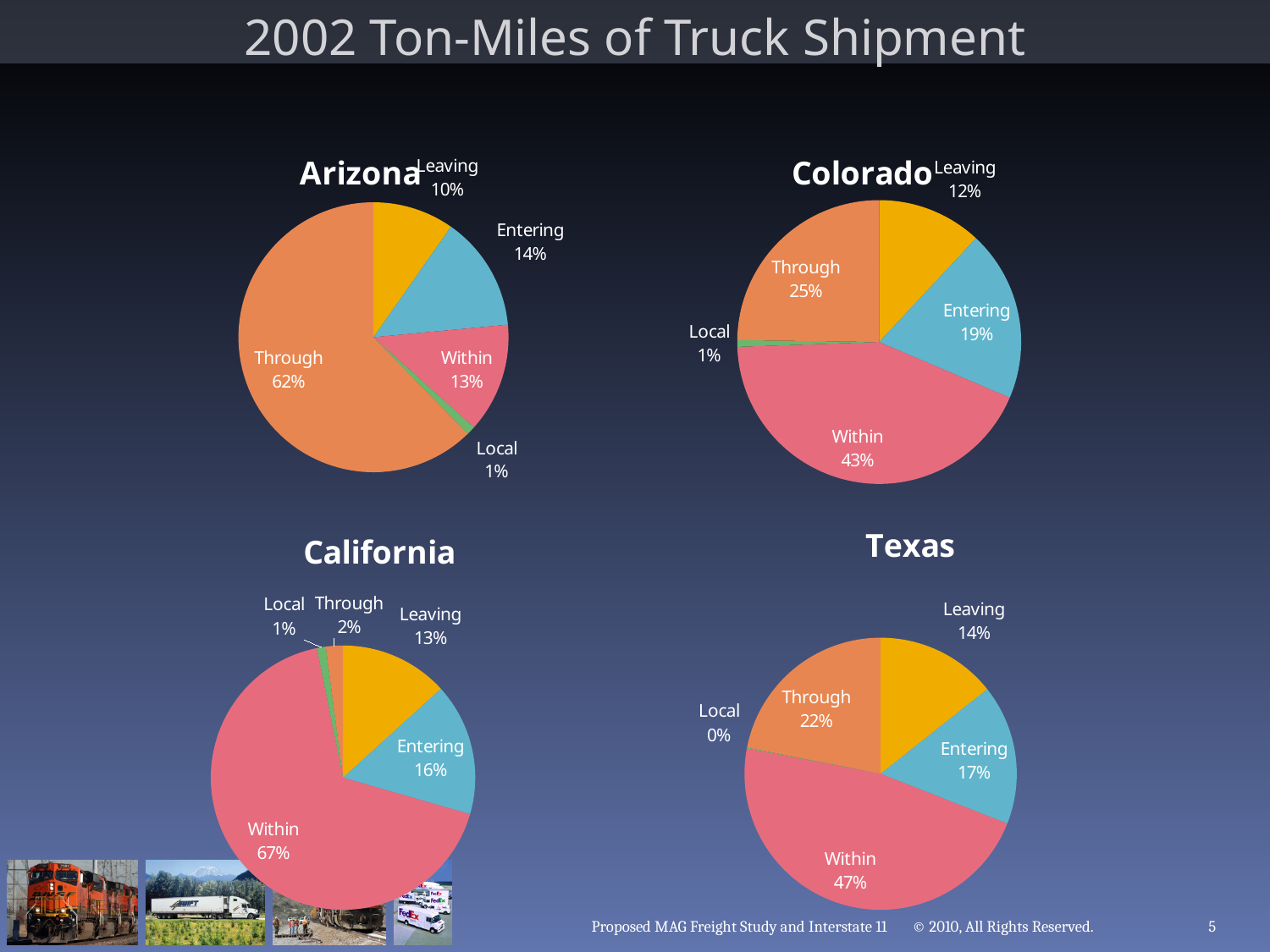
In the Arizona pie chart, which category has the largest share? Through In the California pie chart, which category has the smallest share? Local In the Texas pie chart, which category has the largest share? Within In the Colorado pie chart, what is the difference between the Within and Through shares? 18% In the California pie chart, what share of ton-miles is Entering? 16% In the Texas pie chart, what share of ton-miles is Through? 22% How many categories does the Colorado pie chart show? 5 In the Colorado pie chart, what share of ton-miles is Within? 43% What is the title of the slide containing the four pie charts? 2002 Ton-Miles of Truck Shipment What type of chart is used for California? Pie chart In the Arizona pie chart, what share of ton-miles is Through? 62% In the Texas pie chart, which is larger, Entering or Leaving? Entering